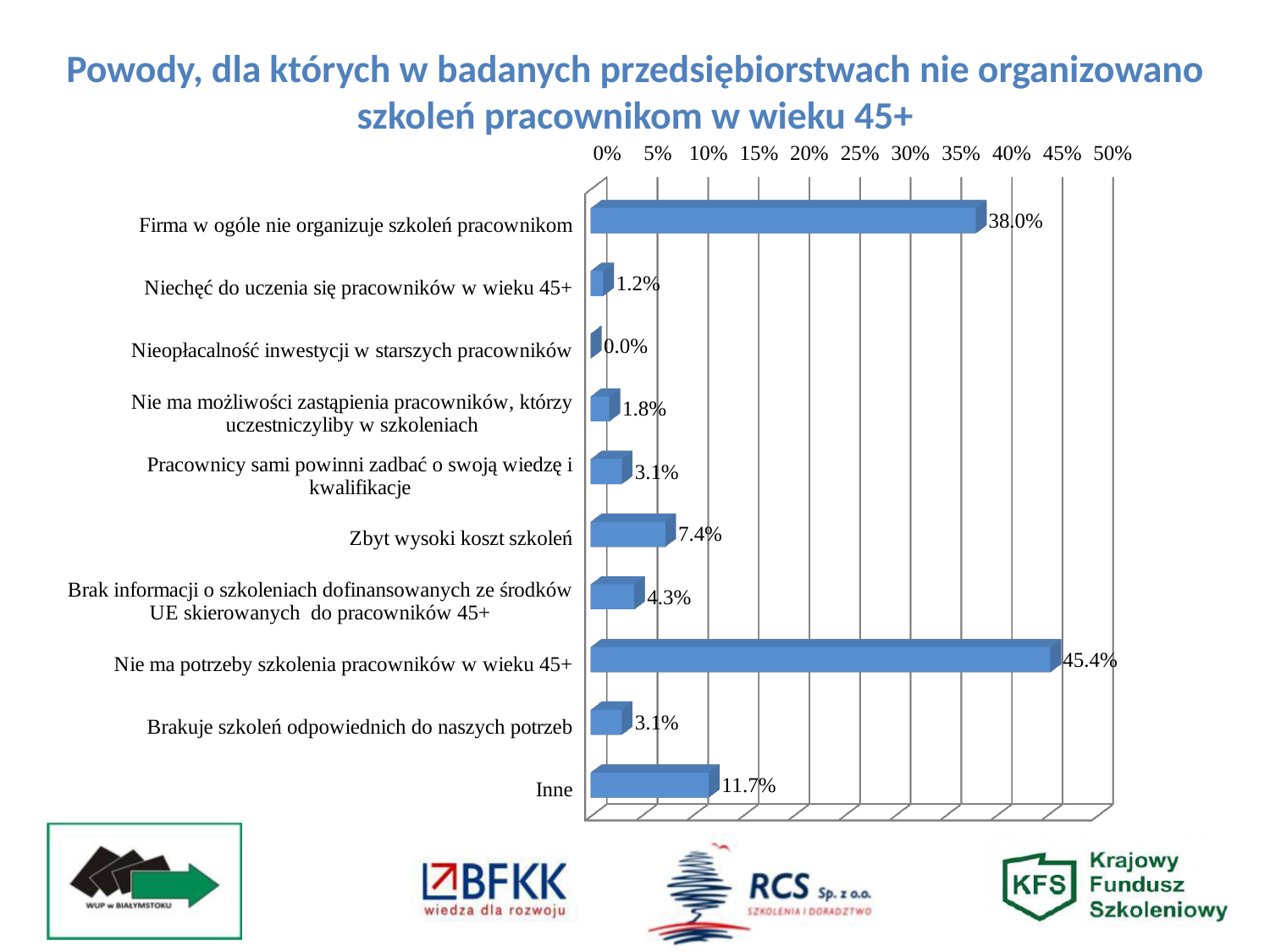
Which category has the lowest value? Nieopłacalność inwestycji w starszych pracowników What is the value for "Inne"? 11.7% Which is larger: the value for "Zbyt wysoki koszt szkoleń" or the value for "Brak informacji o szkoleniach dofinansowanych ze środków UE skierowanych do pracowników 45+"? Zbyt wysoki koszt szkoleń What is the value for "Nie ma potrzeby szkolenia pracowników w wieku 45+"? 45.4% What is the value for "Zbyt wysoki koszt szkoleń"? 7.4% What is the title of the slide? Powody, dla których w badanych przedsiębiorstwach nie organizowano szkoleń pracownikom w wieku 45+ What kind of chart is shown on the slide? Bar chart How many categories are shown in the chart? 10 Which category has the highest value? Nie ma potrzeby szkolenia pracowników w wieku 45+ What is the value for "Firma w ogóle nie organizuje szkoleń pracownikom"? 38.0% What is the difference between the values for "Nie ma potrzeby szkolenia pracowników w wieku 45+" and "Firma w ogóle nie organizuje szkoleń pracownikom"? 7.4 percentage points Is the value for "Inne" greater or less than 10%? greater